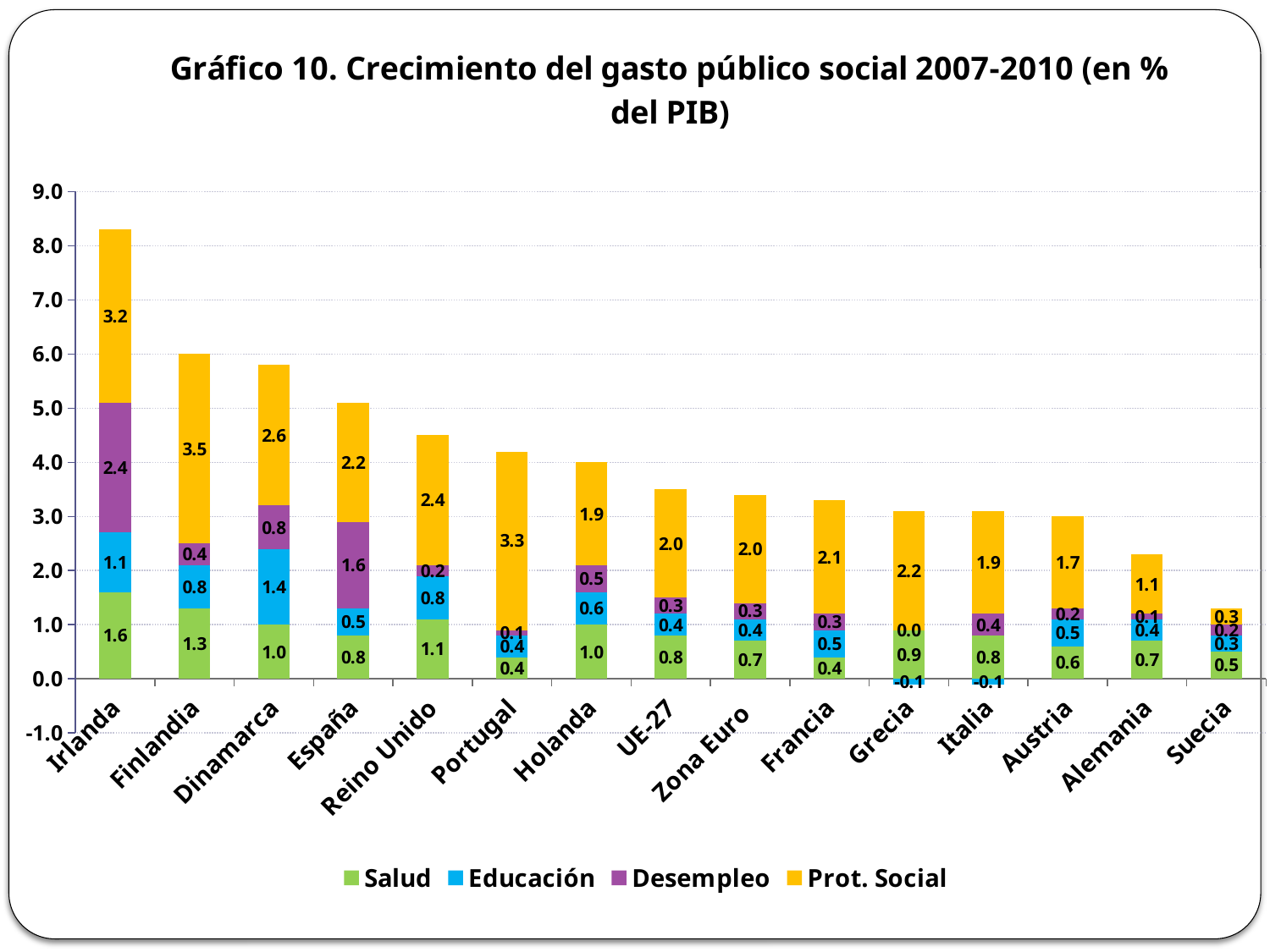
What is the total of the stacked bar for Irlanda? 8.3 What is the title of the chart? Gráfico 10. Crecimiento del gasto público social 2007-2010 (en % del PIB) How many countries or regions are shown on the x axis? 15 Which is larger, the Desempleo value for España or for Dinamarca? España Which country has the highest Prot. Social value? Finlandia What is the Educación value for Dinamarca? 1.4 What is the Prot. Social value for Portugal? 3.3 What type of chart is shown on the slide? Stacked bar chart Which country has the lowest Prot. Social value? Suecia What is the Desempleo value for Irlanda? 2.4 How many series does the legend list? 4 What is the difference between the Salud values for Irlanda and Finlandia? 0.3